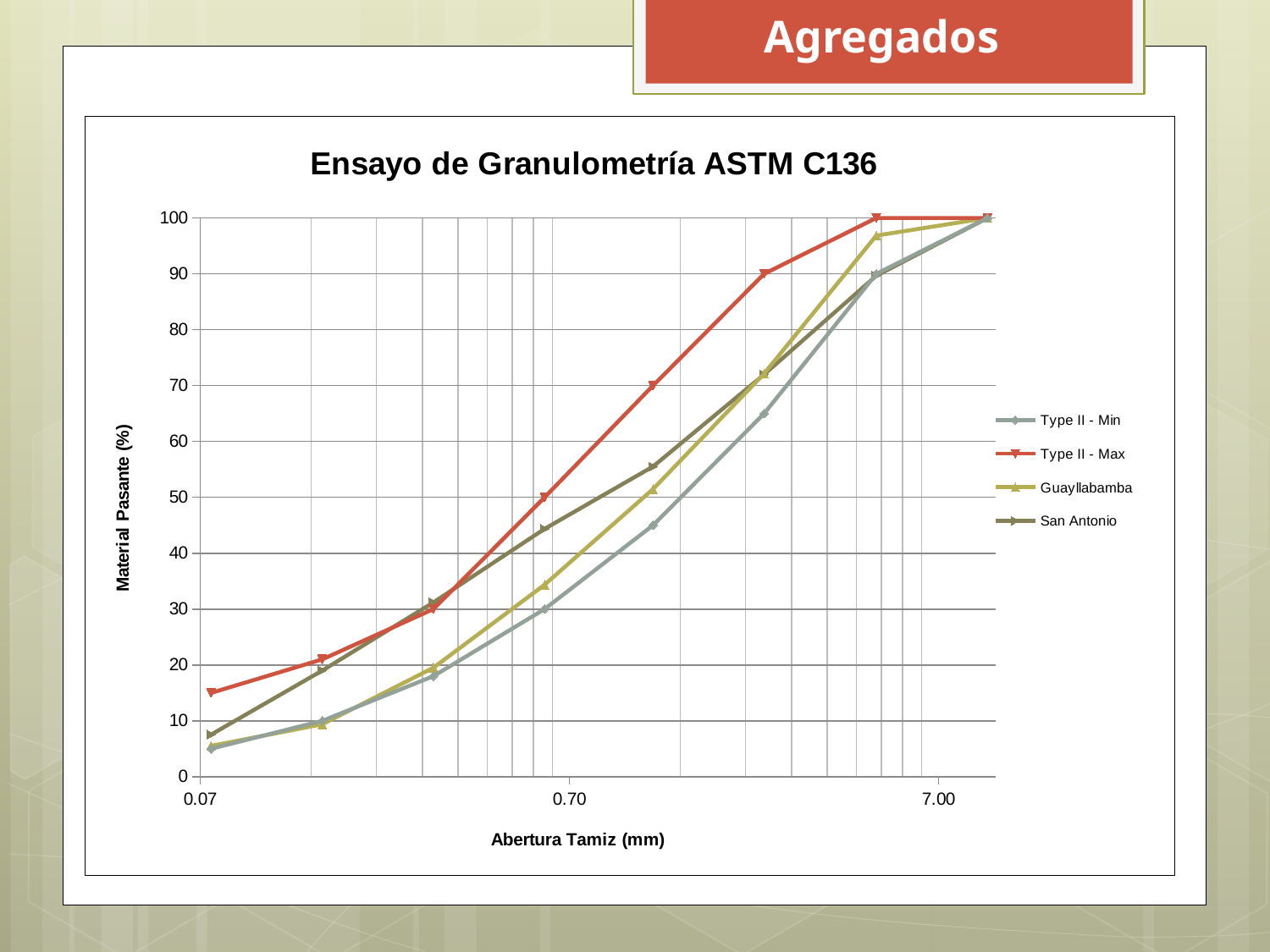
Do the values of the San Antonio series rise or fall along the x axis? rise What is the title of the chart? Ensayo de Granulometría ASTM C136 What kind of chart is shown on the slide? line chart Which series has the highest value at 0.70 mm? Type II - Max Is the value for Type II - Min at 0.07 mm greater or less than 10? less How many series does the legend list? 4 Is the value for San Antonio at 0.70 mm greater or less than 40? greater Do the values of the Type II - Max series rise or fall as the sieve opening increases along the x axis? rise Is the value for Guayllabamba at 0.70 mm greater or less than 30? greater What is the label of the vertical axis? Material Pasante (%) At 0.07 mm, which is larger: Type II - Max or Type II - Min? Type II - Max